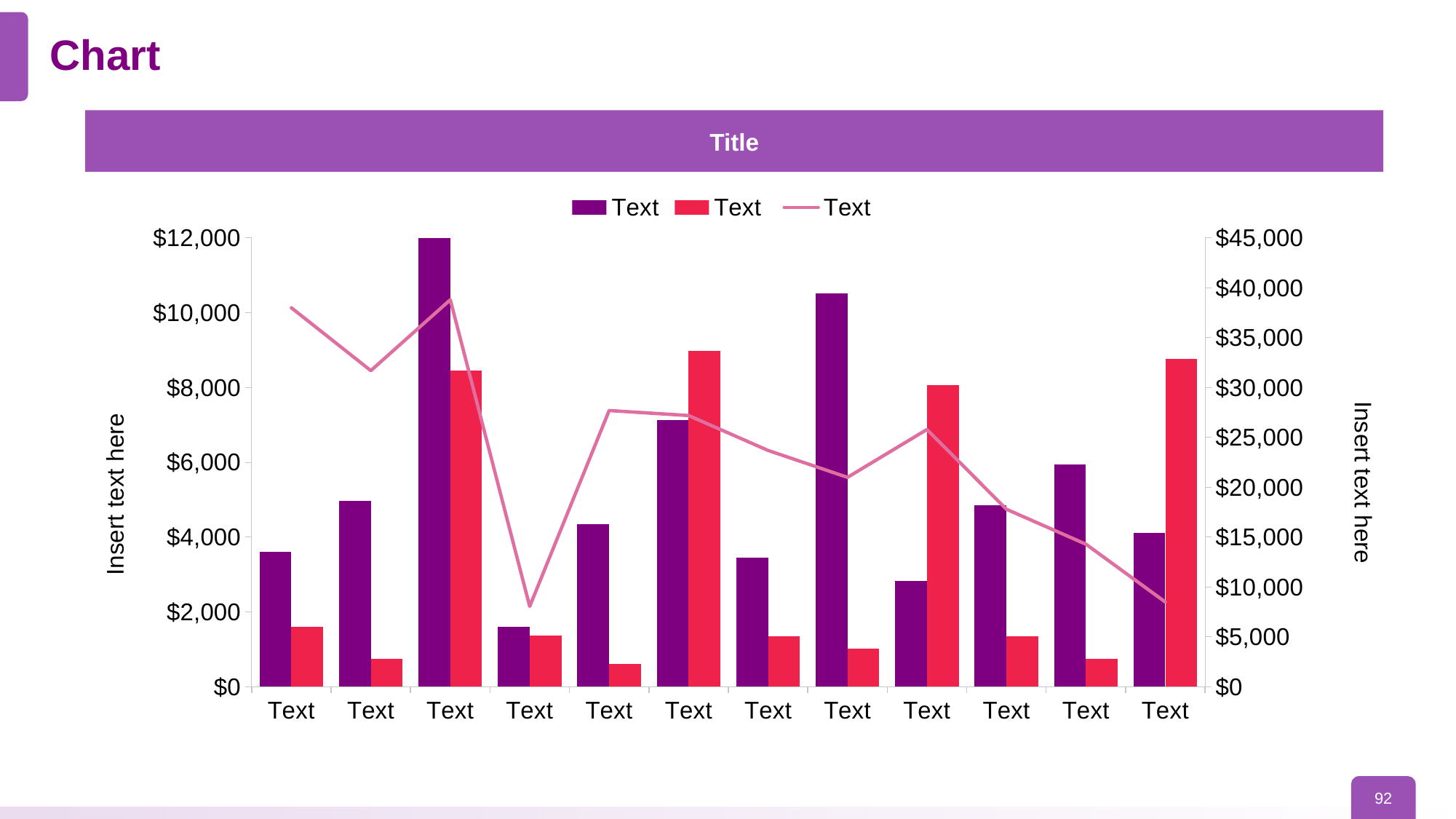
How many series does the chart's legend list? 3 Is the tallest purple bar greater or less than $10,000? greater Which is taller in the last category: the purple bar or the red bar? The red bar Is the lowest point of the line series, read on the right axis, greater or less than $10,000? less What kind of chart is shown on the slide? A bar chart combined with a line What is the highest tick value shown on the left vertical axis? $12,000 Does the line series rise or fall across the last four categories? Fall How many categories are plotted along the x axis of the chart? 12 Which is taller in the first category: the purple bar or the red bar? The purple bar What is the title shown above the chart? Title Is the highest point of the line series, read on the right axis, greater or less than $35,000? greater